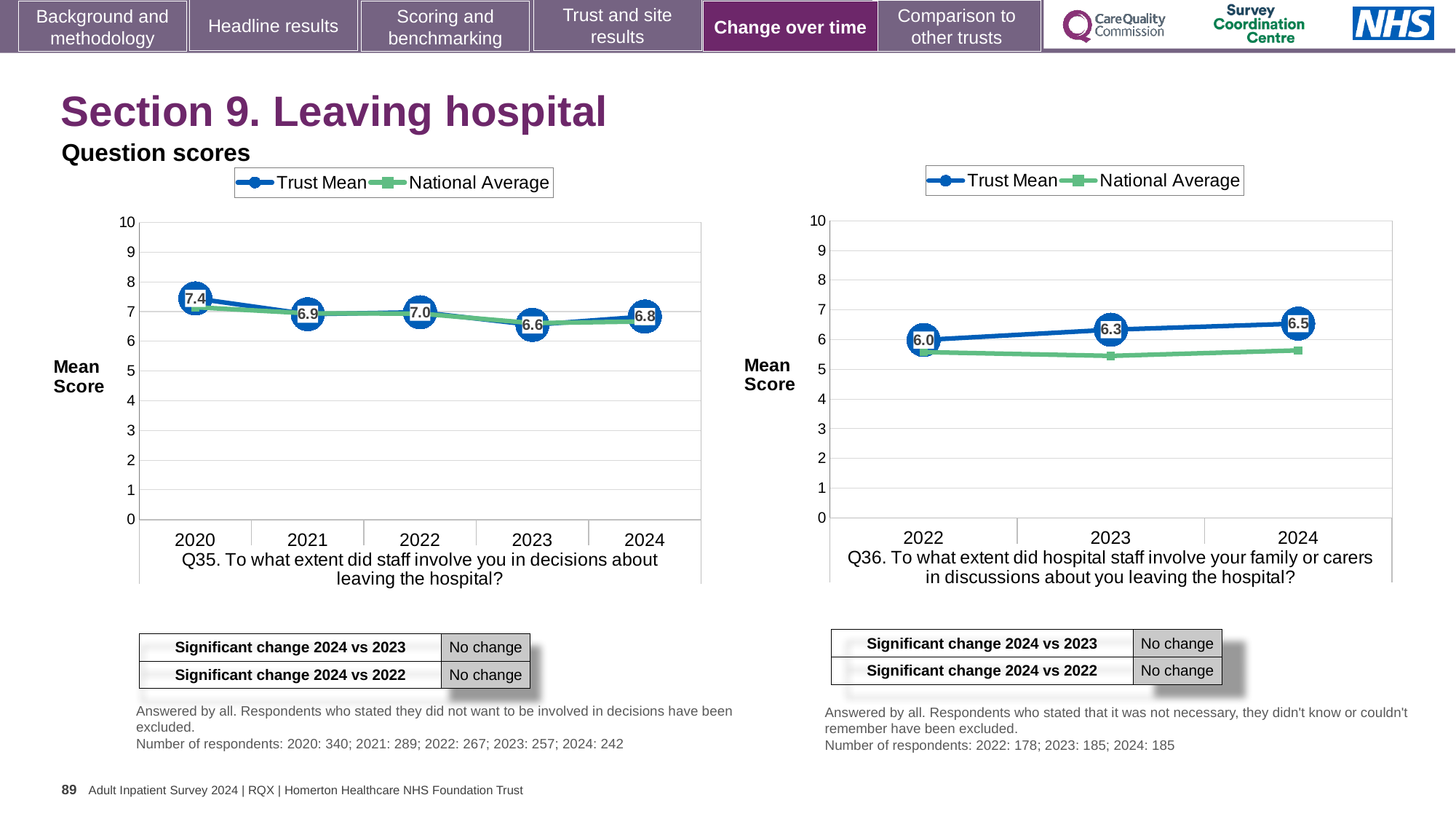
In the Q36 chart on the right, which is larger in 2024, the Trust Mean or the National Average? Trust Mean In the Q35 chart on the left, what is the Trust Mean for 2023? 6.6 In the Q35 chart on the left, what is the Trust Mean for 2020? 7.4 In the Q36 chart on the right, what is the Trust Mean for 2024? 6.5 In the Q35 chart on the left, which year has the highest Trust Mean? 2020 In the Q36 chart on the right, is the National Average for 2023 greater or less than 6? less How many series does the legend of the Q36 chart on the right list? 2 In the Q35 chart on the left, how many years are plotted on the x axis? 5 In the Q35 chart on the left, what is the difference between the Trust Mean for 2020 and 2024? 0.6 In the Q36 chart on the right, does the Trust Mean rise or fall from 2022 to 2024? rise In the Q35 chart on the left, which year has the lowest Trust Mean? 2023 In the Q36 chart on the right, what is the Trust Mean for 2022? 6.0